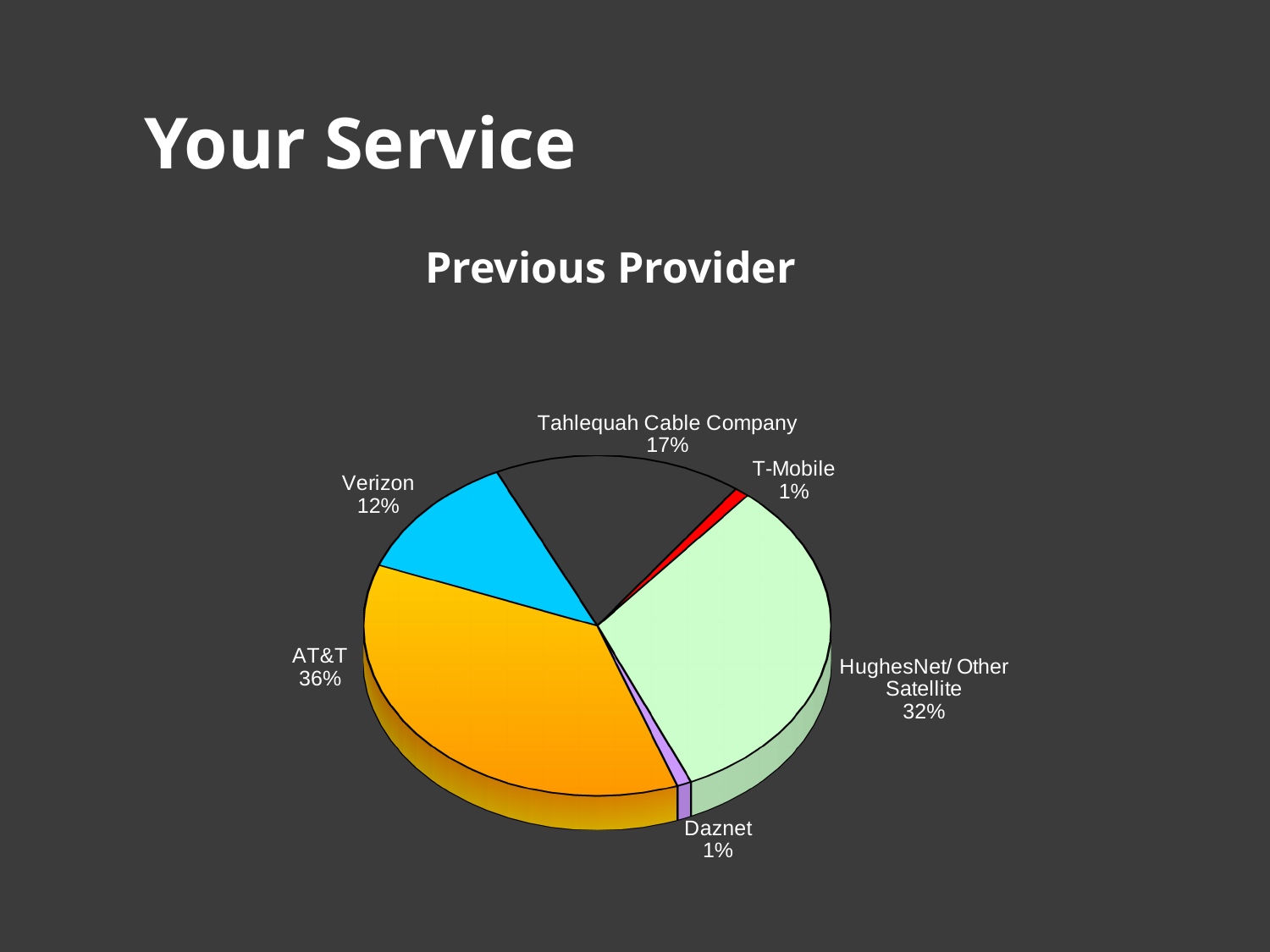
What kind of chart is shown on the slide? Pie chart What percentage is shown for T-Mobile? 1% What is the title of the chart? Previous Provider Which previous provider has the largest share of the pie chart? AT&T What percentage is shown for Tahlequah Cable Company? 17% What is the difference in percentage points between AT&T and HughesNet/ Other Satellite? 4% What percentage is shown for Verizon? 12% What is the difference in percentage points between Tahlequah Cable Company and Verizon? 5% What percentage does the pie chart show for HughesNet/ Other Satellite? 32% Which has a larger share, Tahlequah Cable Company or Verizon? Tahlequah Cable Company What share of the Previous Provider pie chart is AT&T? 36% How many providers are shown as slices in the pie chart? 6